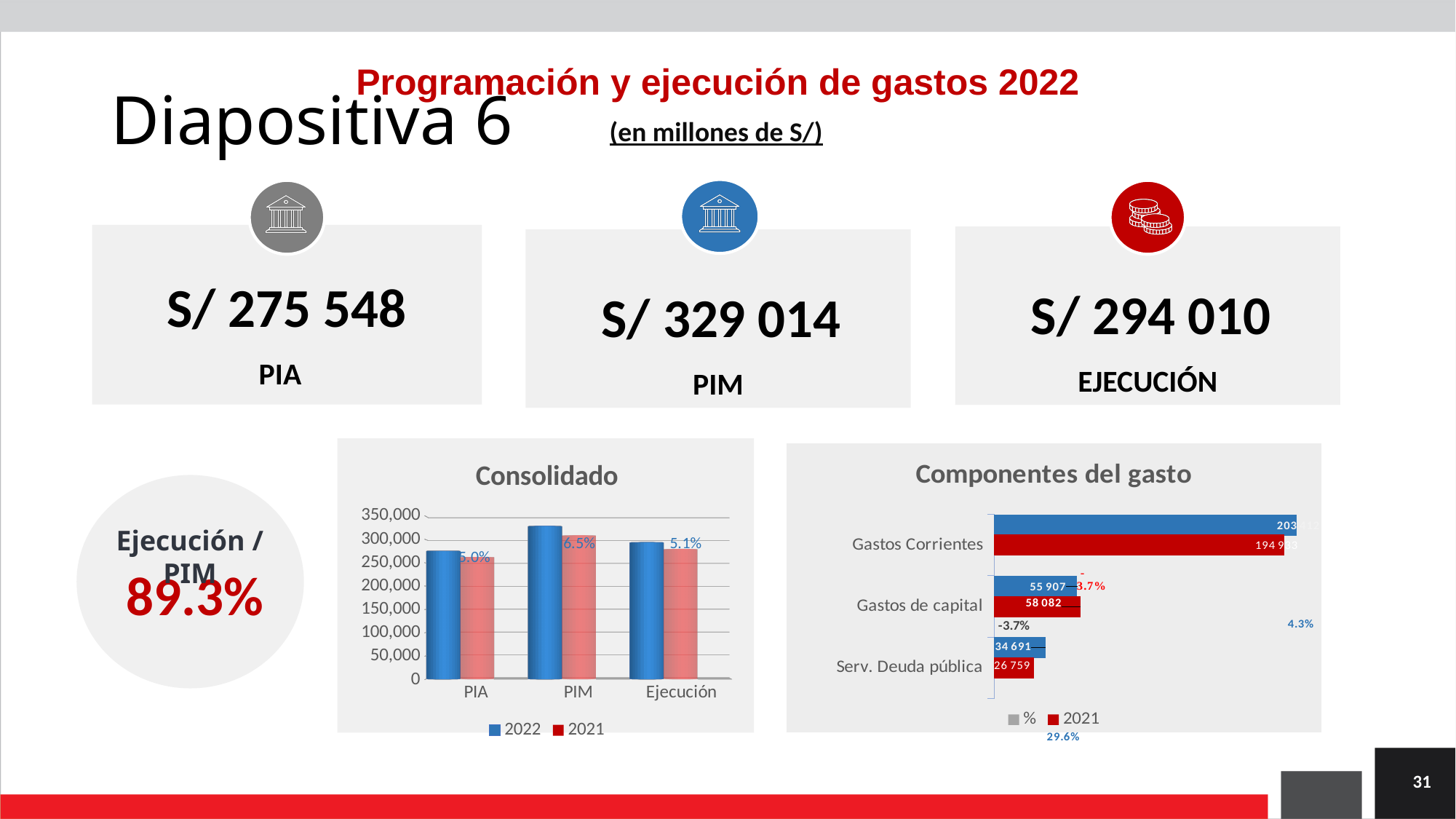
In the "Componentes del gasto" chart, which category has the highest values? Gastos Corrientes In the "Componentes del gasto" chart, what is the difference between the blue bar (34 691) and the 2021 bar (26 759) for Serv. Deuda pública? 7 932 In the "Componentes del gasto" chart, what is the 2021 value for Gastos de capital? 58 082 In the "Consolidado" chart, is the 2022 value for PIA greater or less than 300,000? less In the "Consolidado" chart, is the 2022 value for PIM greater or less than 300,000? greater In the "Consolidado" chart, which category has the highest 2022 value? PIM In the "Componentes del gasto" chart, what is the value of the blue bar for Serv. Deuda pública? 34 691 In the "Componentes del gasto" chart, which is larger for Gastos de capital: the blue bar or the 2021 bar? the 2021 bar In the "Consolidado" chart, what percentage label is shown above the Ejecución bars? 5.1% How many series does the legend of the "Consolidado" chart list? 2 How many categories are shown on the x axis of the "Consolidado" chart? 3 What kind of chart is the "Consolidado" chart? bar chart